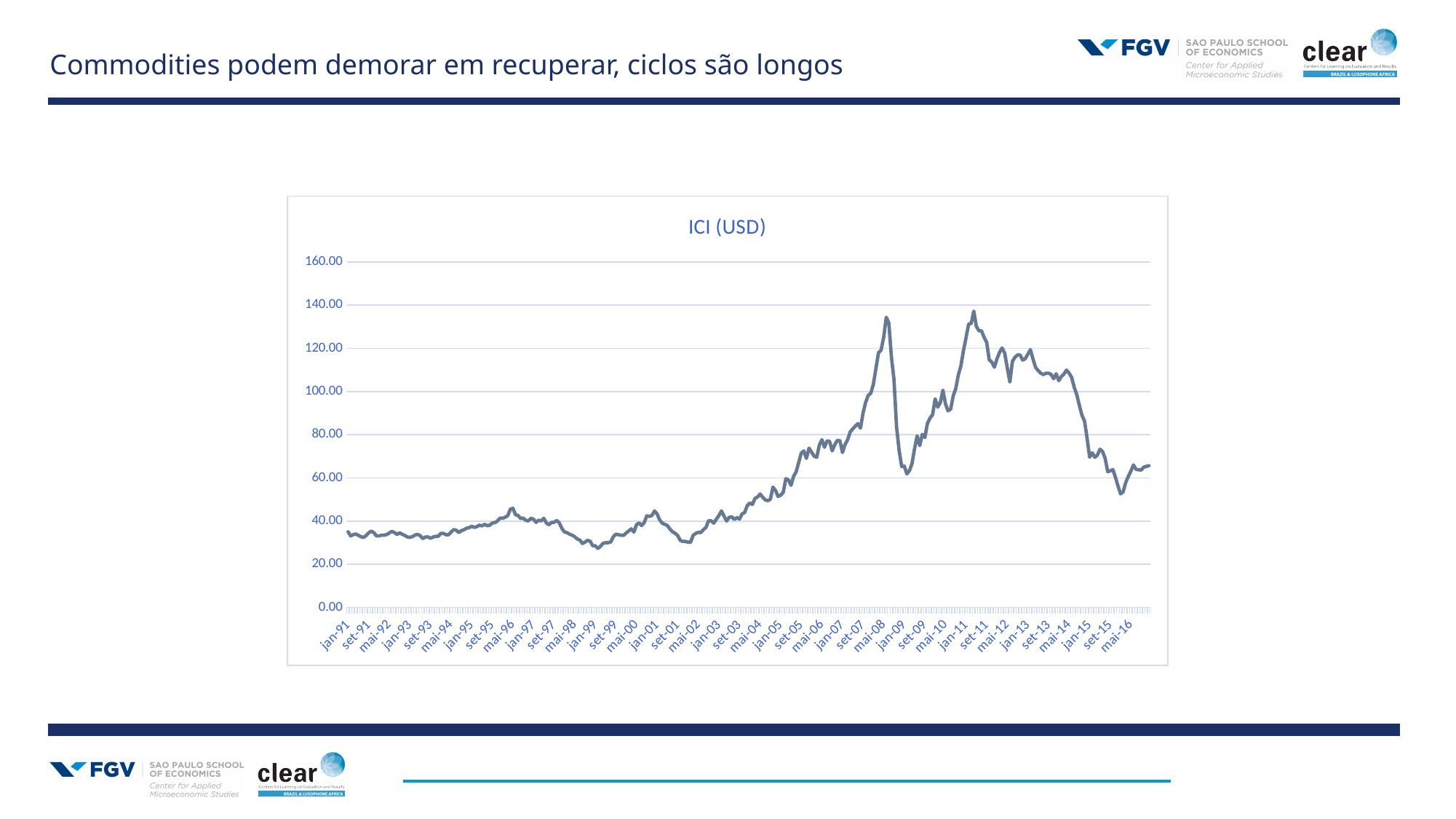
What is the title of the chart? ICI (USD) Which is higher, the value for mai-08 or the value for jan-09? mai-08 What is the highest value shown on the y axis of the chart? 160.00 Is the value for mai-16 greater or less than 60? greater How many lines (series) are plotted in the chart? 1 Is the value for jan-09 greater or less than 80? less Does the ICI (USD) line generally rise or fall between set-11 and set-15? fall What kind of chart is shown on the slide? line chart Which is higher, the value for jan-91 or the value for mai-16? mai-16 Is the value for mai-08 greater or less than 120? greater